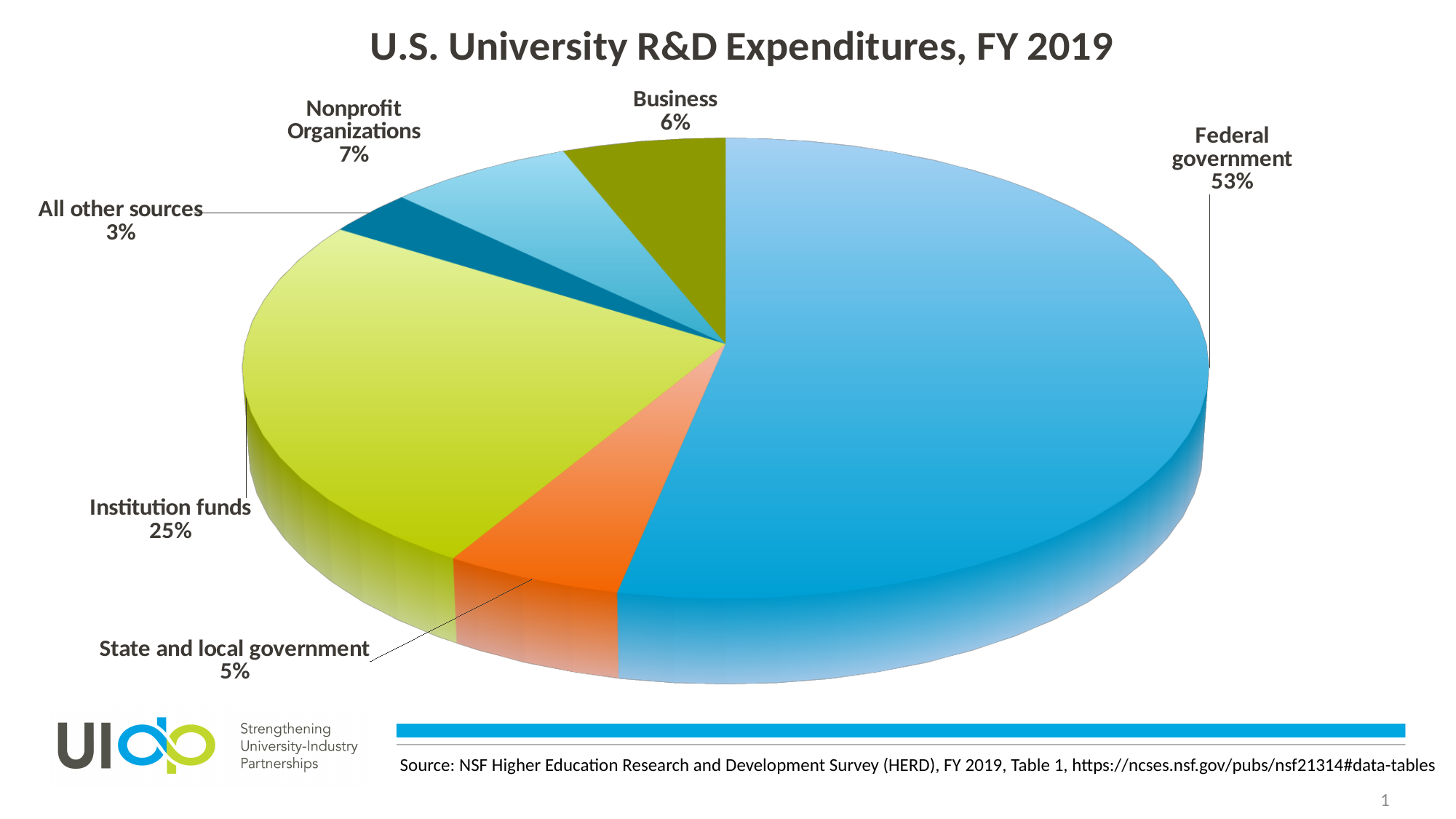
What colour is the Federal government slice? Blue What share is shown for Nonprofit Organizations? 7% Which is larger, the Business share or the Nonprofit Organizations share? Nonprofit Organizations What is the title of the chart? U.S. University R&D Expenditures, FY 2019 What kind of chart is shown on the slide? Pie chart What share of U.S. university R&D expenditures in FY 2019 came from the Federal government? 53% Which source accounts for the smallest share of the pie? All other sources How many slices does the pie chart have? 6 Which source accounts for the largest share of the pie? Federal government How many percentage points larger is the Federal government share than the Institution funds share? 28 What percentage is shown for State and local government? 5% What percentage of the pie is labelled Institution funds? 25%